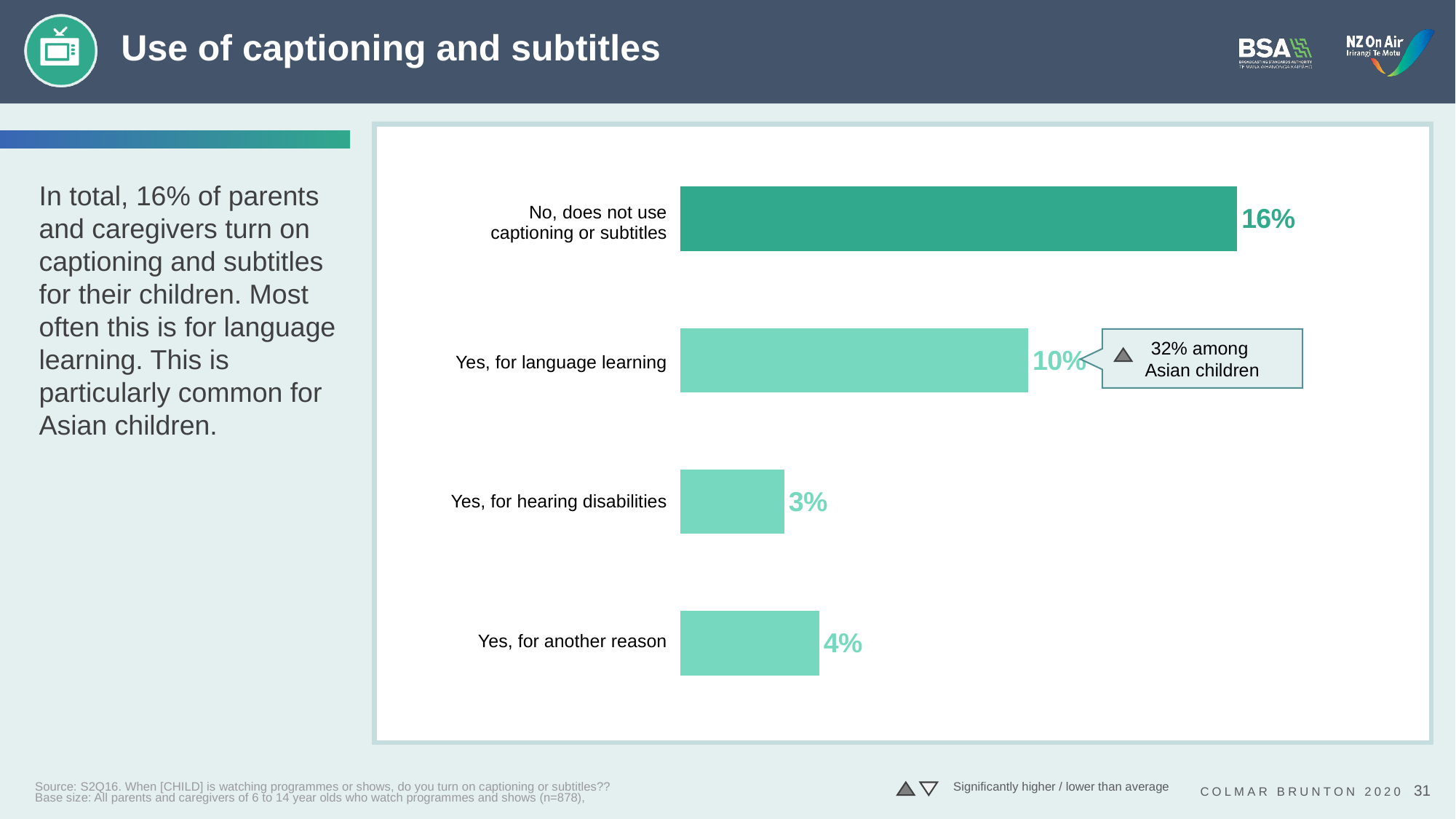
What is the title of the slide containing the chart? Use of captioning and subtitles What is the value for 'Yes, for another reason'? 4% What is the value for 'Yes, for language learning'? 10% Which category has the lowest value? Yes, for hearing disabilities Which category has the highest value? No, does not use captioning or subtitles What kind of chart is shown on the slide? Bar chart How many categories are shown in the chart? 4 Which is larger: 'Yes, for another reason' or 'Yes, for hearing disabilities'? Yes, for another reason What is the difference between 'No, does not use captioning or subtitles' and 'Yes, for language learning'? 6 percentage points According to the callout on the chart, what percentage of Asian children's parents use captioning for language learning? 32% What percentage of parents and caregivers do not use captioning or subtitles? 16% What is the value for 'Yes, for hearing disabilities'? 3%